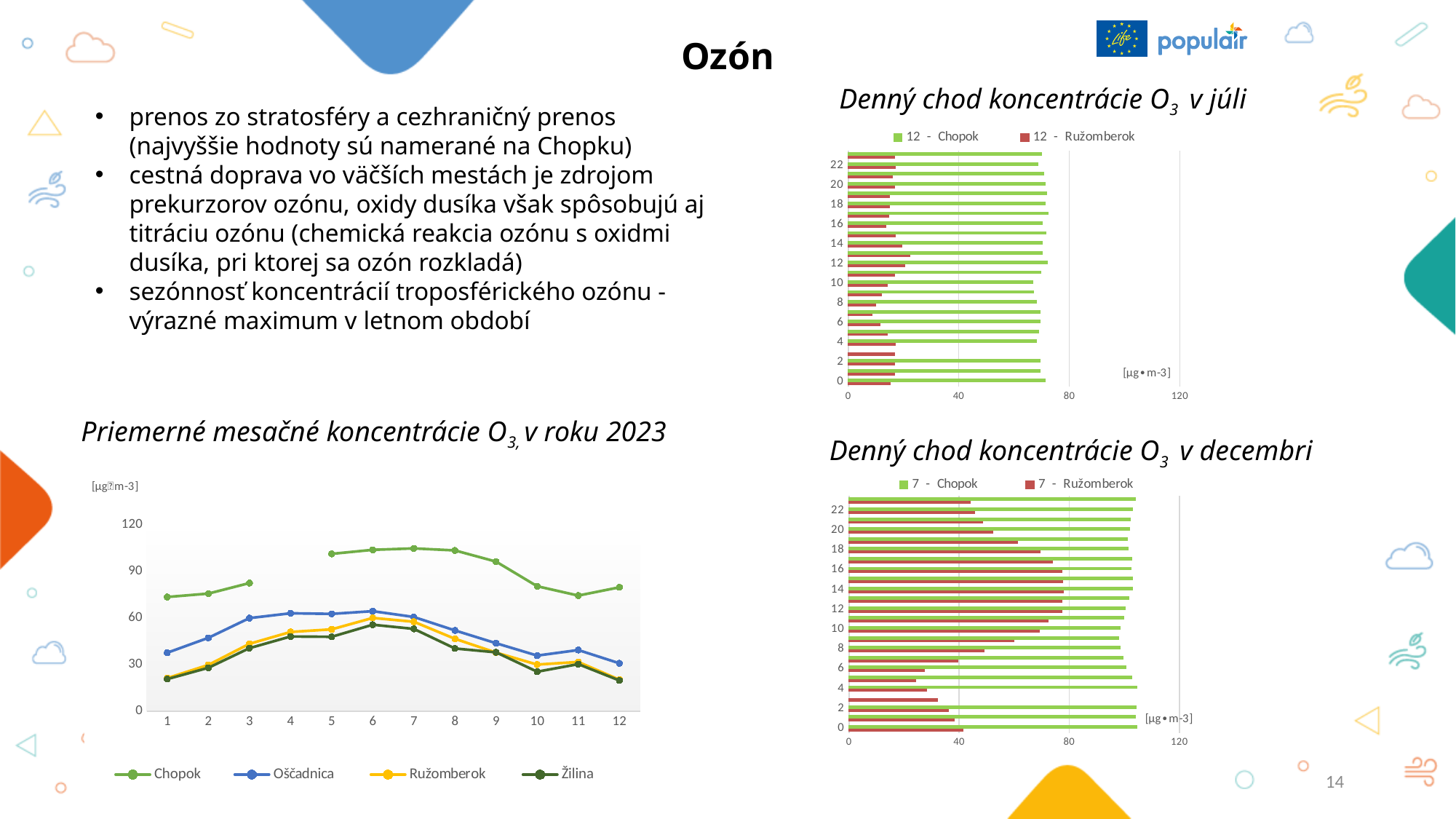
What kind of chart is "Denný chod koncentrácie O3 v júli"? bar chart In "Denný chod koncentrácie O3 v decembri", which is larger at hour 14, Chopok or Ružomberok? Chopok In "Priemerné mesačné koncentrácie O3 v roku 2023", does the Chopok line rise or fall from month 7 to month 12? fall In "Priemerné mesačné koncentrácie O3 v roku 2023", is the value for Chopok in month 7 greater or less than 90? greater How many months are plotted along the x axis of "Priemerné mesačné koncentrácie O3 v roku 2023"? 12 In "Denný chod koncentrácie O3 v decembri", is the value for Ružomberok at hour 14 greater or less than 40? greater What kind of chart is "Priemerné mesačné koncentrácie O3 v roku 2023"? line chart How many series does the legend of "Denný chod koncentrácie O3 v júli" list? 2 How many series does the legend of "Priemerné mesačné koncentrácie O3 v roku 2023" list? 4 In "Priemerné mesačné koncentrácie O3 v roku 2023", is the value for Žilina in month 1 greater or less than 30? less In "Priemerné mesačné koncentrácie O3 v roku 2023", which series has the highest value in month 7? Chopok